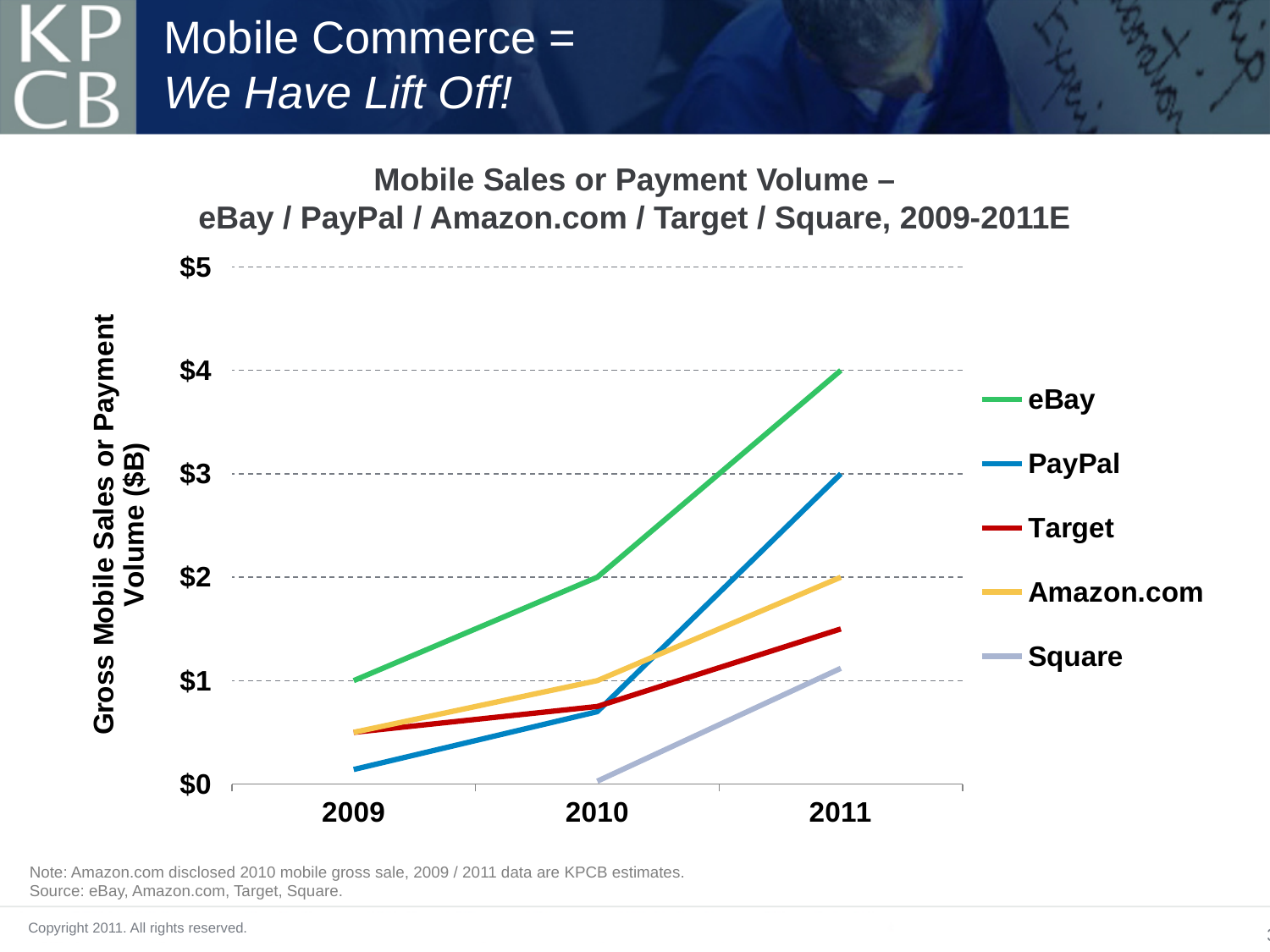
How many years are shown on the x axis? 3 How many series does the legend list? 5 What is the value for eBay in 2009? $1 What is the difference between eBay's 2011 value and its 2009 value? $3 What is the value for eBay in 2011? $4 What is the value for PayPal in 2011? $3 Which series has the lowest value in 2011? Square What kind of chart is shown on the slide? line chart Is the value for Square in 2010 greater or less than $1? less Which is larger in 2011, PayPal or Amazon.com? PayPal Is the value for Target in 2011 greater or less than $2? less Which series has the highest value in 2011? eBay